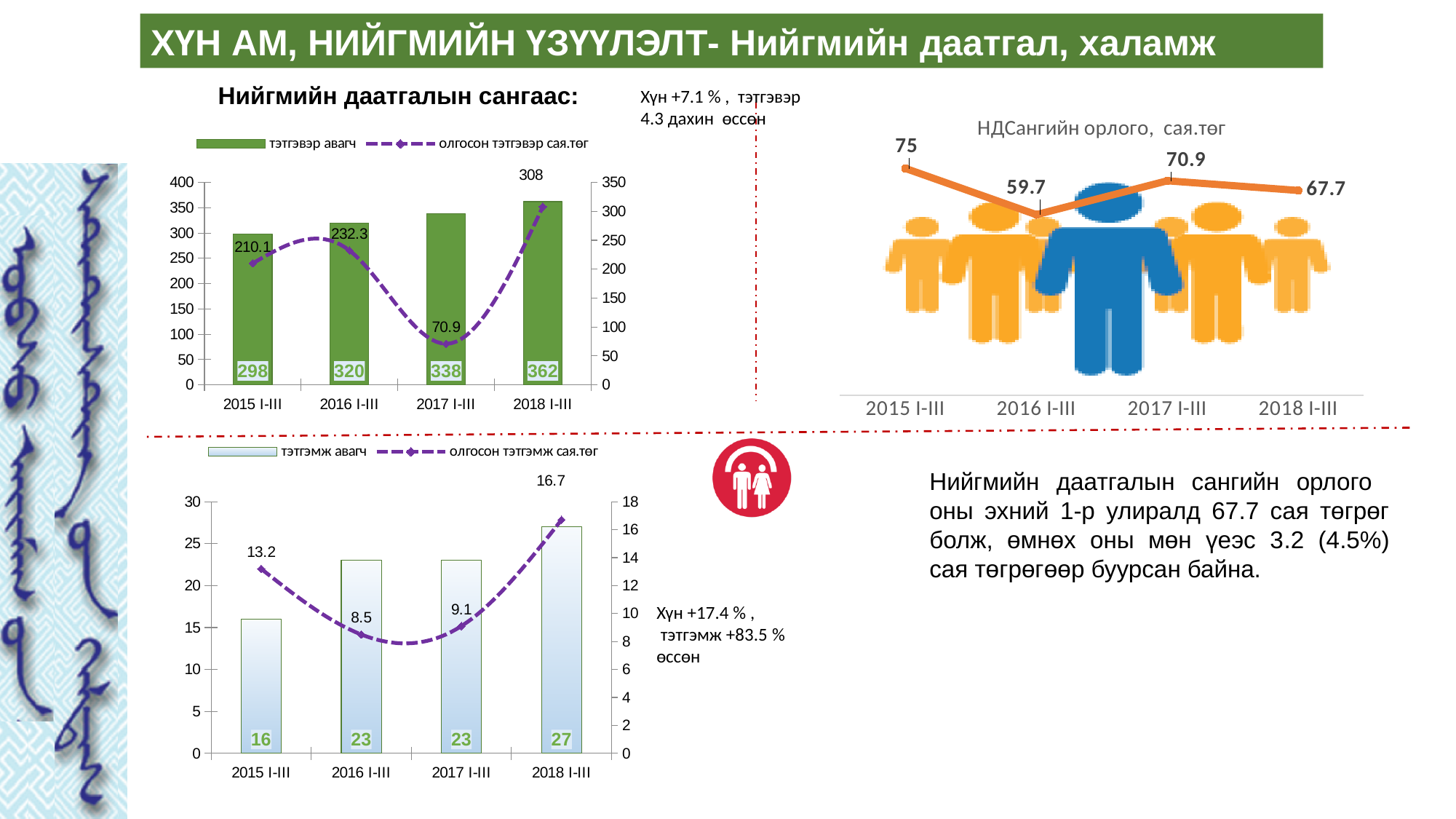
In the top-left chart, what is the difference between the 'тэтгэвэр авагч' bars for 2018 I-III and 2015 I-III? 64 In the top-right chart titled 'НДСангийн орлого, сая.төг', what is the difference between the 2017 I-III and 2018 I-III values? 3.2 In the bottom-left chart, what is the value of the 'тэтгэмж авагч' bar for 2015 I-III? 16 In the top-left chart, what is the value of the 'тэтгэвэр авагч' bar for 2018 I-III? 362 In the bottom-left chart, is the 'олгосон тэтгэмж сая.төг' value for 2016 I-III larger or smaller than for 2017 I-III? smaller In the top-right chart titled 'НДСангийн орлого, сая.төг', what is the value for 2016 I-III? 59.7 In the top-left chart, what is the 'олгосон тэтгэвэр сая.төг' value for 2017 I-III? 70.9 How many series does the legend of the bottom-left chart list? 2 In the top-left chart, which period has the lowest 'олгосон тэтгэвэр сая.төг' value? 2017 I-III In the top-right chart titled 'НДСангийн орлого, сая.төг', which period has the highest value? 2015 I-III In the bottom-left chart, which period has the highest 'олгосон тэтгэмж сая.төг' value? 2018 I-III In the top-left chart, do the 'тэтгэвэр авагч' bars rise or fall from 2015 I-III to 2018 I-III? rise